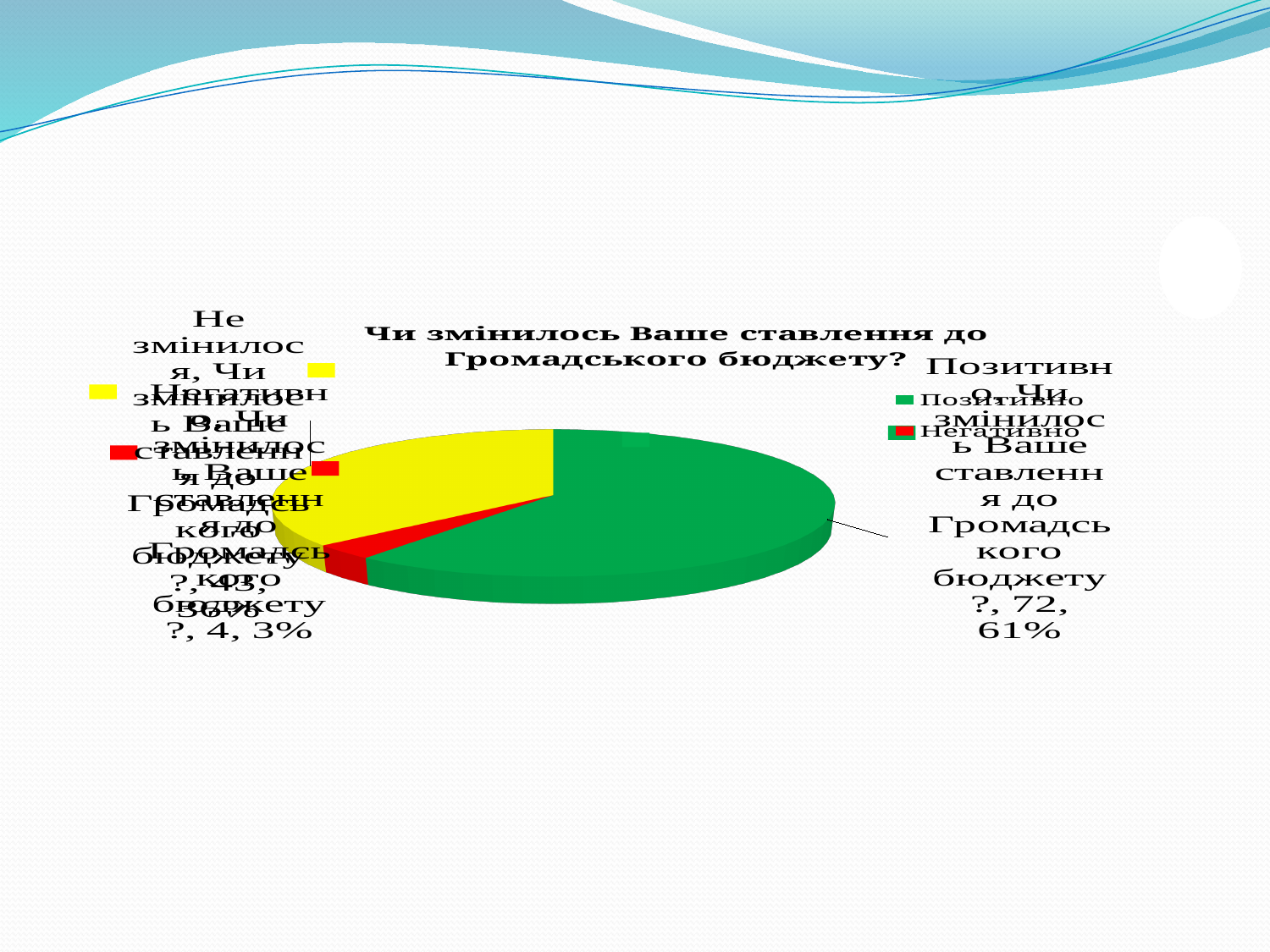
What is the title of the chart? Чи змінилось Ваше ставлення до Громадського бюджету? How many respondents answered "Позитивно"? 72 What percentage share does the "Негативно" slice have? 3% What percentage share does the "Позитивно" slice have? 61% Which answer has the largest slice of the pie? Позитивно What colour is the "Позитивно" slice? green Which is larger, the yellow slice or the red slice? the yellow slice Which is larger, the "Позитивно" slice or the "Негативно" slice? Позитивно What kind of chart is shown on the slide? pie chart How many respondents answered "Негативно"? 4 Which answer has the smallest slice of the pie? Негативно What is the difference between the number of "Позитивно" and "Негативно" responses? 68